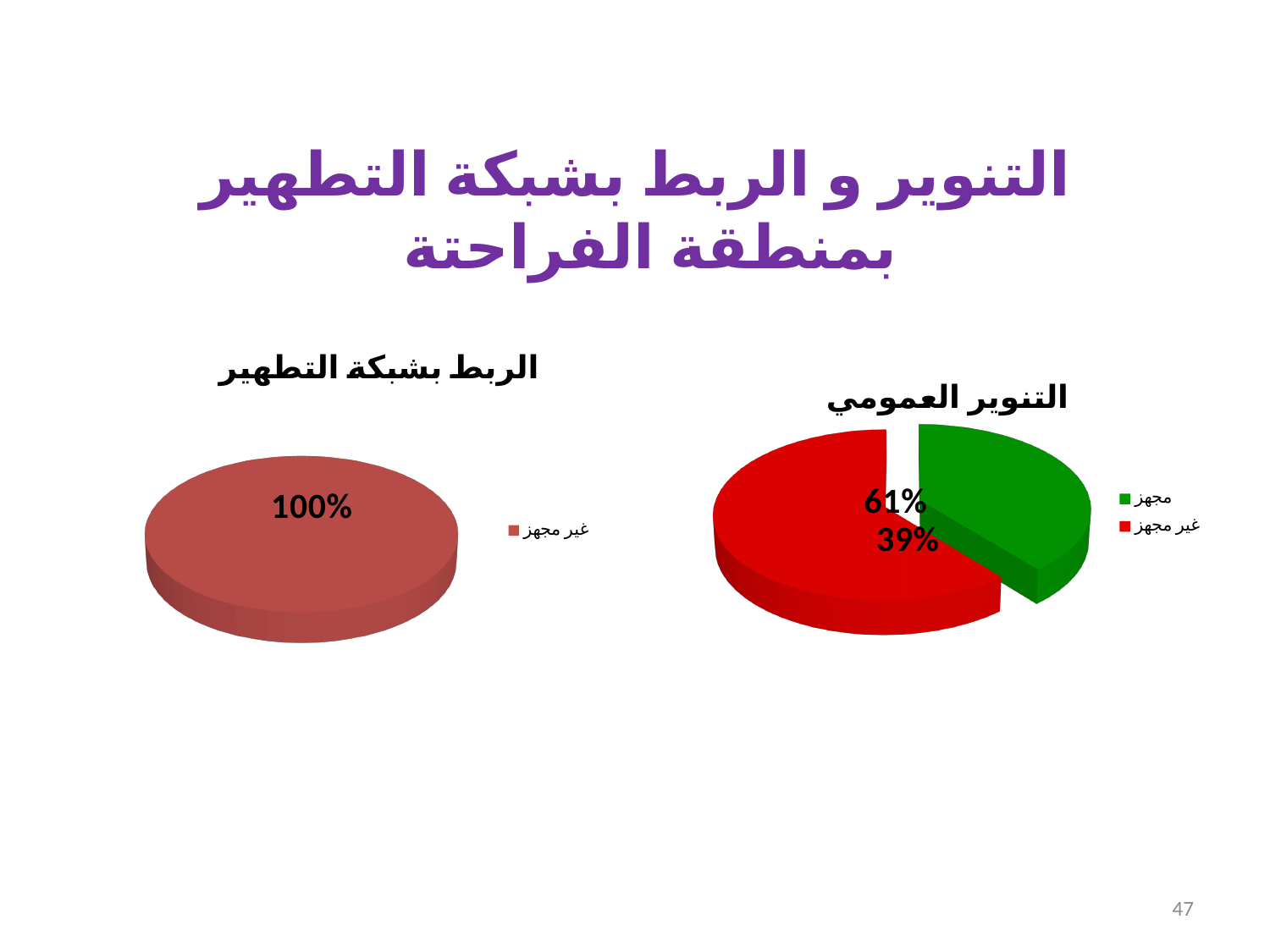
How many slices does the chart titled "التنوير العمومي" have? 2 How many entries does the legend of the chart titled "التنوير العمومي" list? 2 What kind of chart is the chart titled "التنوير العمومي"? pie chart In the chart titled "الربط بشبكة التطهير", what share does "غير مجهز" have? 100% In the chart titled "التنوير العمومي", which slice is larger, "مجهز" or "غير مجهز"? غير مجهز In the chart titled "التنوير العمومي", what is the difference between the shares of "غير مجهز" and "مجهز"? 22% How many slices does the chart titled "الربط بشبكة التطهير" have? 1 In the chart titled "التنوير العمومي", what share does "مجهز" have? 39% What kind of chart is the chart titled "الربط بشبكة التطهير"? pie chart In the chart titled "التنوير العمومي", what share does "غير مجهز" have? 61% In the chart titled "التنوير العمومي", what colour is the "مجهز" slice? green How many entries does the legend of the chart titled "الربط بشبكة التطهير" list? 1